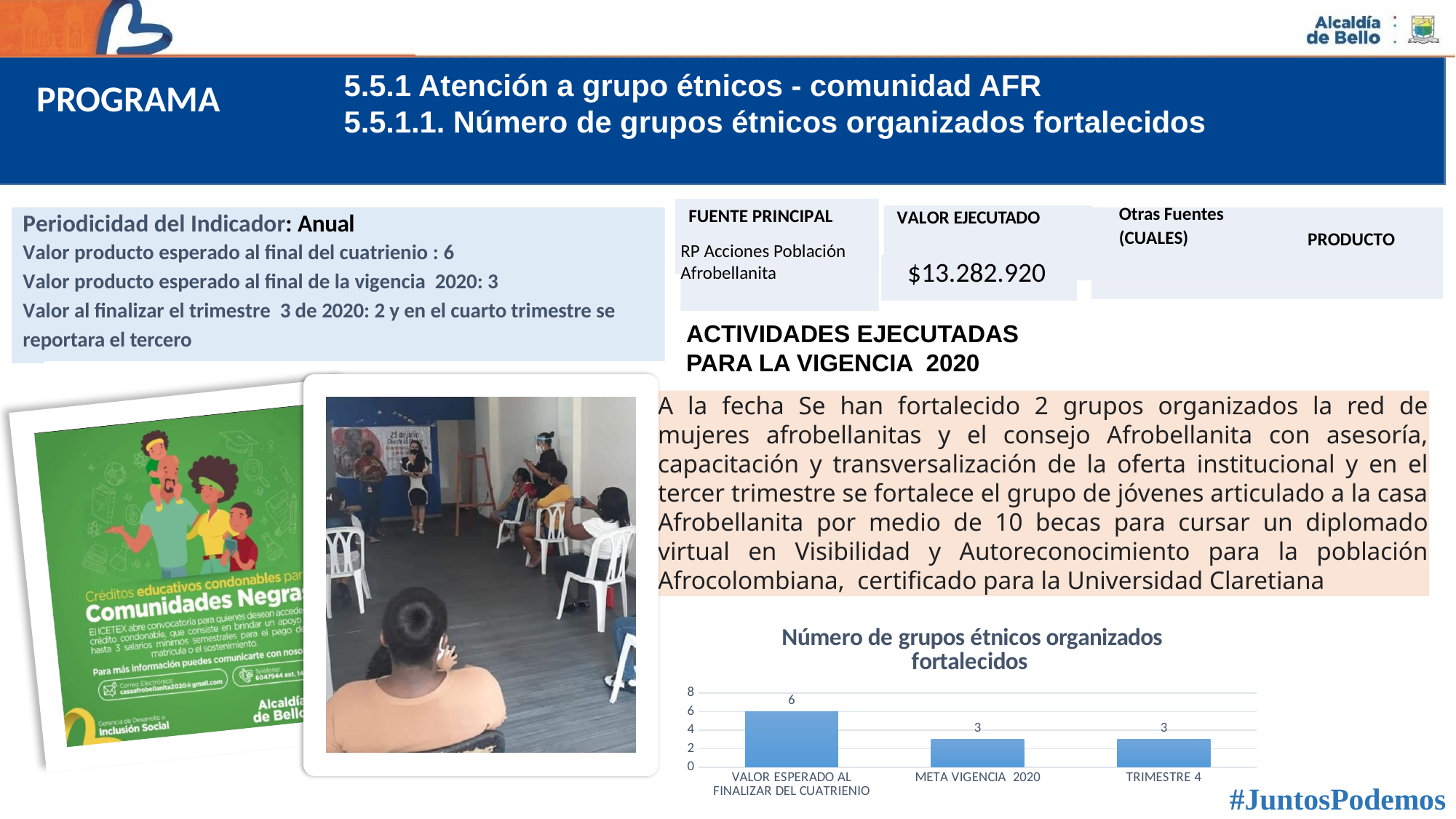
What kind of chart is shown on the slide? bar chart What is the value for VALOR ESPERADO AL FINALIZAR DEL CUATRIENIO? 6 How many categories are shown on the chart? 3 Is the value for TRIMESTRE 4 greater or less than 4? less What is the value for TRIMESTRE 4? 3 What is the title of the chart? Número de grupos étnicos organizados fortalecidos Which is larger, the value for VALOR ESPERADO AL FINALIZAR DEL CUATRIENIO or the value for TRIMESTRE 4? VALOR ESPERADO AL FINALIZAR DEL CUATRIENIO What is the difference between the value for VALOR ESPERADO AL FINALIZAR DEL CUATRIENIO and the value for META VIGENCIA 2020? 3 What is the highest value shown on the chart's vertical axis? 8 What is the value for META VIGENCIA 2020? 3 Is the value for VALOR ESPERADO AL FINALIZAR DEL CUATRIENIO greater or less than 4? greater Which category has the highest value? VALOR ESPERADO AL FINALIZAR DEL CUATRIENIO